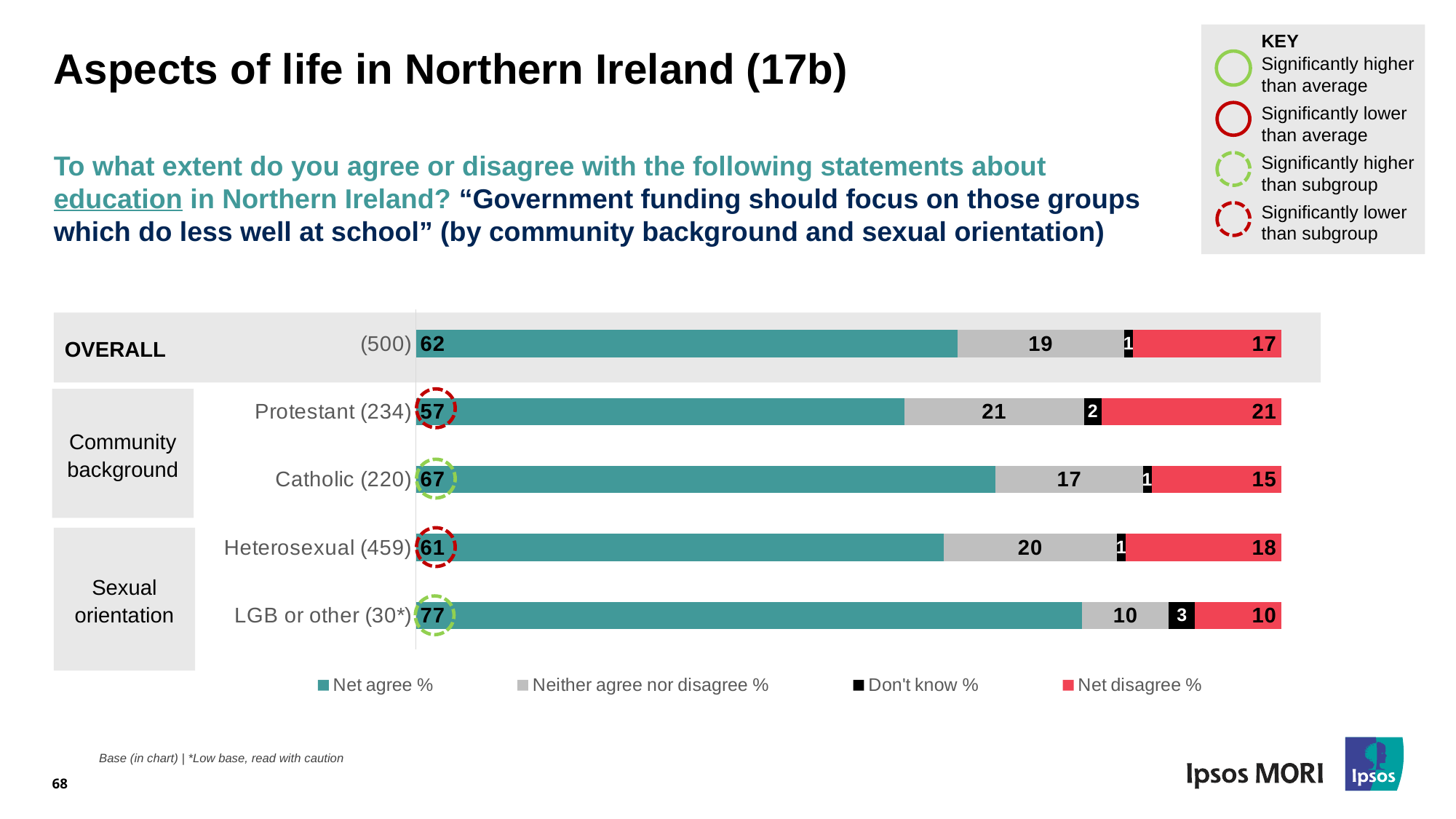
What is the Net disagree % for Protestant respondents? 21 Which group has the highest Net agree %? LGB or other What is the Neither agree nor disagree % for LGB or other respondents? 10 How many groups (bars) are shown in the chart? 5 Which group has the lowest Net agree %? Protestant What is the Net agree % for the Overall group? 62 What is the difference in Net agree % between Catholic and Protestant respondents? 10 What is the base size shown for the Heterosexual group? 459 Which has a higher Net disagree %, Heterosexual or LGB or other? Heterosexual What kind of chart is shown on the slide? Stacked bar chart How many series does the legend list? 4 What is the Don't know % for Catholic respondents? 1